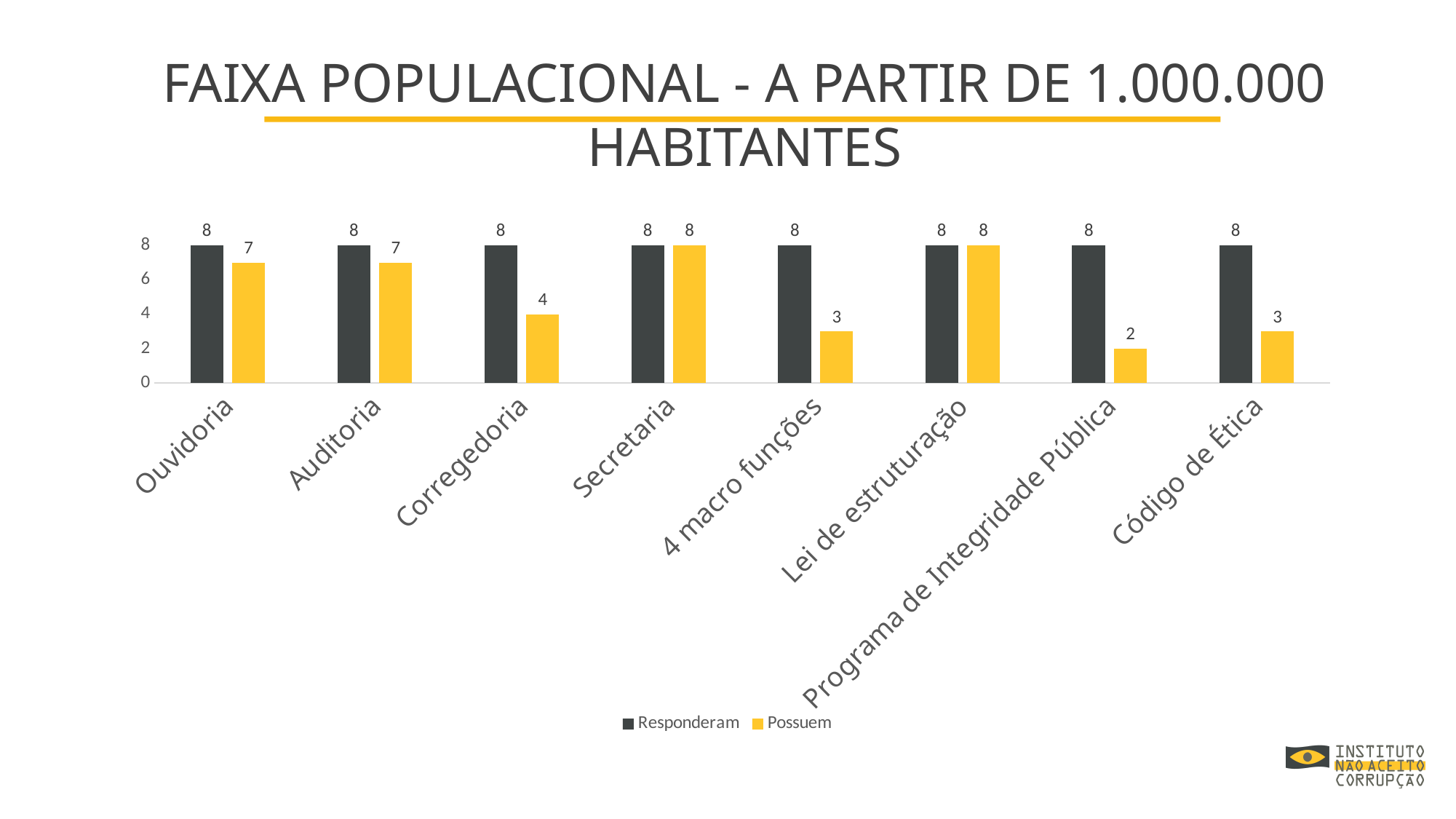
How many series does the legend list? 2 What is the value of Possuem for Corregedoria? 4 What kind of chart is shown on the slide? Bar chart What is the value of Possuem for Programa de Integridade Pública? 2 Which is larger, the Possuem value for Ouvidoria or for Código de Ética? Ouvidoria What is the difference between Responderam and Possuem for 4 macro funções? 5 What is the title of the chart? FAIXA POPULACIONAL - A PARTIR DE 1.000.000 HABITANTES Which series is shown in yellow? Possuem What is the value of Responderam for Secretaria? 8 How many categories are shown on the x axis? 8 What is the difference between Responderam and Possuem for Auditoria? 1 Which category has the lowest Possuem value? Programa de Integridade Pública